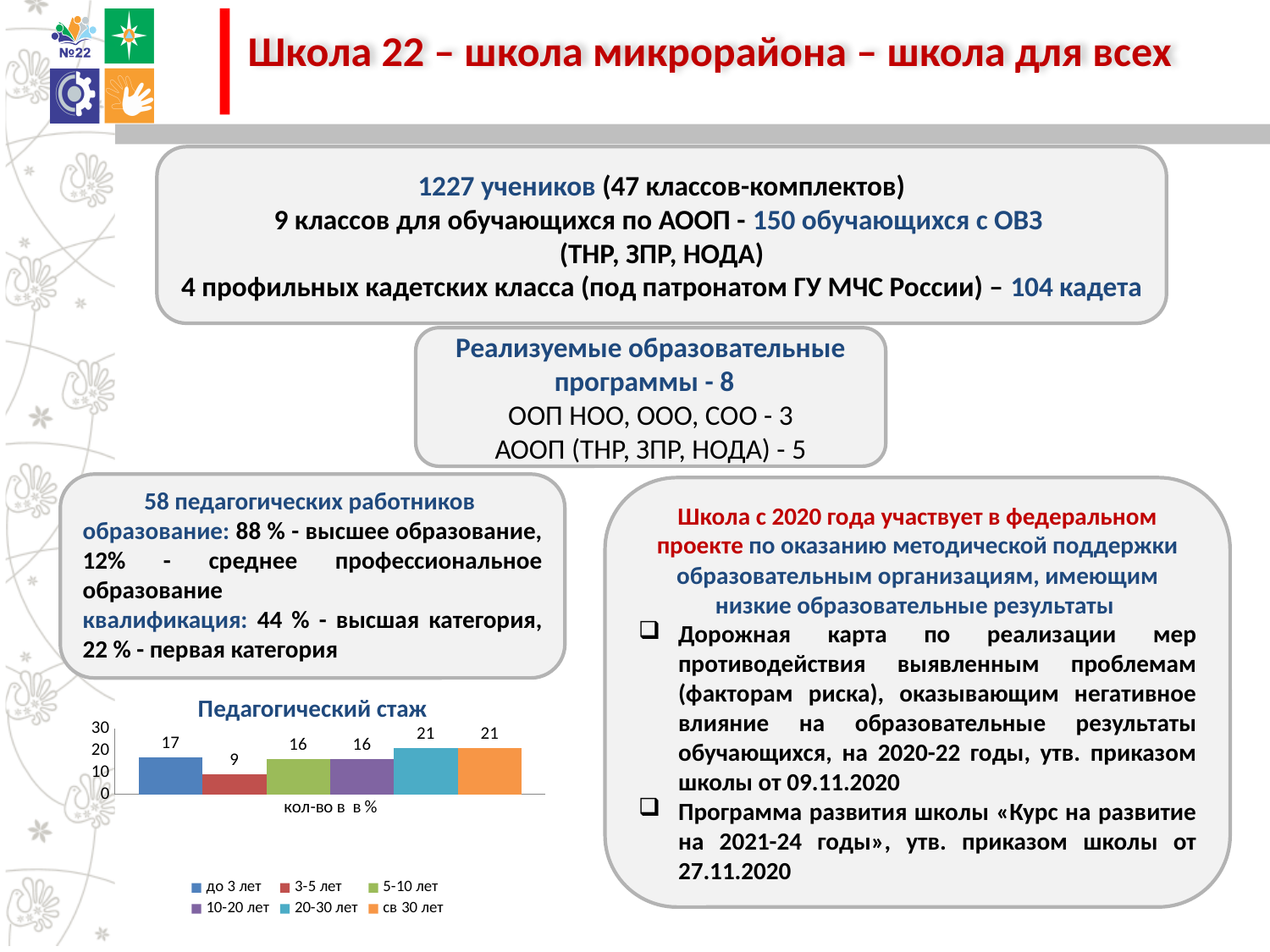
Is the value for '3-5 лет' in the 'Педагогический стаж' chart greater or less than 10? less What is the title of the chart on the slide? Педагогический стаж In the 'Педагогический стаж' chart, which is larger: the value for 'св 30 лет' or the value for '5-10 лет'? св 30 лет What is the value for the series 'до 3 лет' in the 'Педагогический стаж' chart? 17 Which series has the lowest value in the 'Педагогический стаж' chart? 3-5 лет What is the total of all the values shown in the 'Педагогический стаж' chart? 100 What is the difference between the values for 'до 3 лет' and '3-5 лет' in the 'Педагогический стаж' chart? 8 How many series does the legend of the 'Педагогический стаж' chart list? 6 What is the value for the series '20-30 лет' in the 'Педагогический стаж' chart? 21 What is the value for the series '10-20 лет' in the 'Педагогический стаж' chart? 16 What kind of chart is 'Педагогический стаж'? bar chart What is the value for the series '3-5 лет' in the 'Педагогический стаж' chart? 9